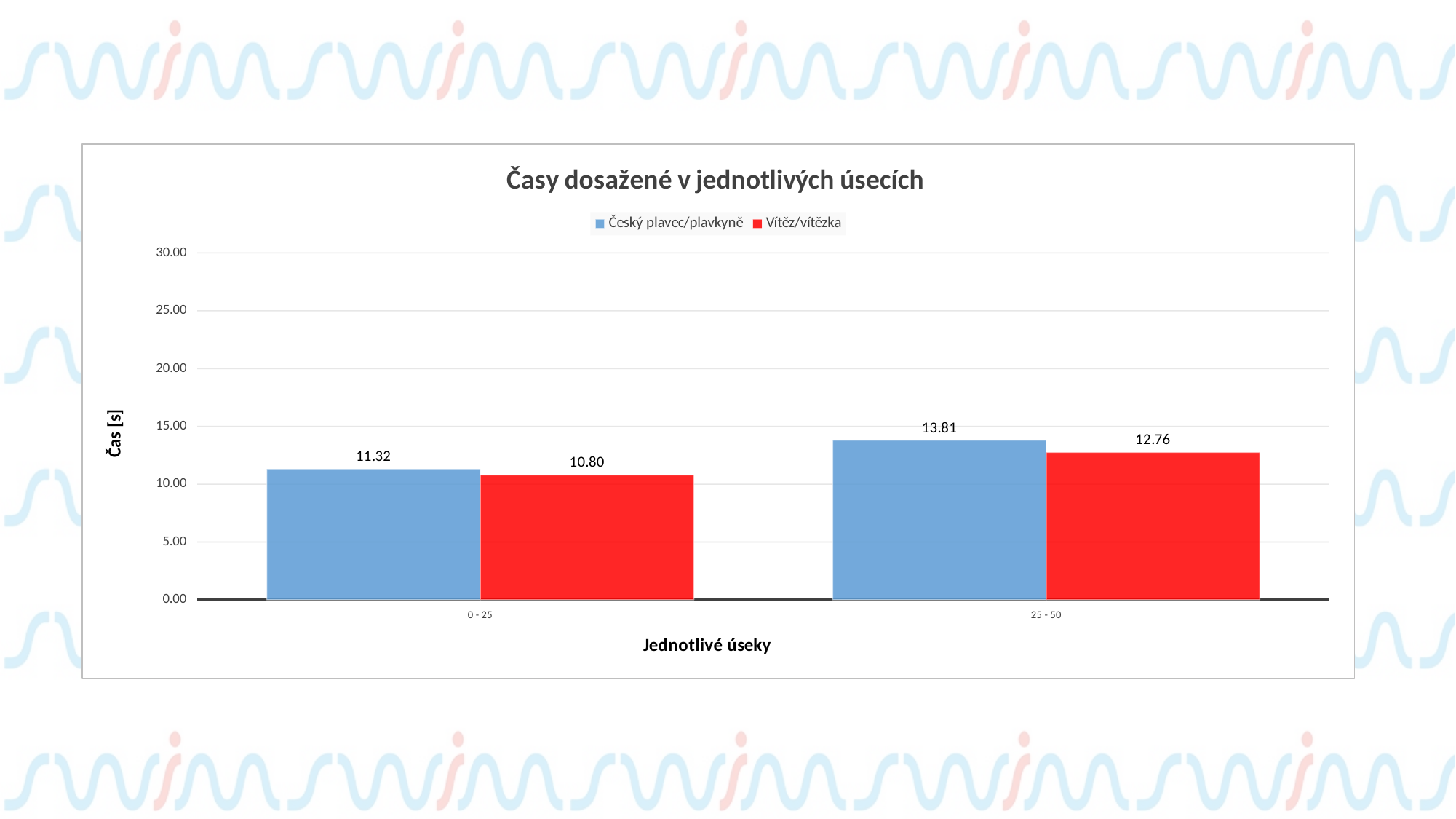
What is the difference between Český plavec/plavkyně and Vítěz/vítězka in the 25 - 50 segment? 1.05 What is the title of the chart? Časy dosažené v jednotlivých úsecích What is the value for Vítěz/vítězka in the 25 - 50 segment? 12.76 In the 0 - 25 segment, which series has the larger value, Český plavec/plavkyně or Vítěz/vítězka? Český plavec/plavkyně What is the value for Vítěz/vítězka in the 0 - 25 segment? 10.80 How many series does the legend list? 2 Is the value for Český plavec/plavkyně in the 25 - 50 segment greater or less than 15.00? less Which segment has the highest value for Český plavec/plavkyně? 25 - 50 What kind of chart is shown on the slide? bar chart How many segments are shown on the x axis? 2 Which segment has the lowest value for Vítěz/vítězka? 0 - 25 What is the value for Český plavec/plavkyně in the 0 - 25 segment? 11.32